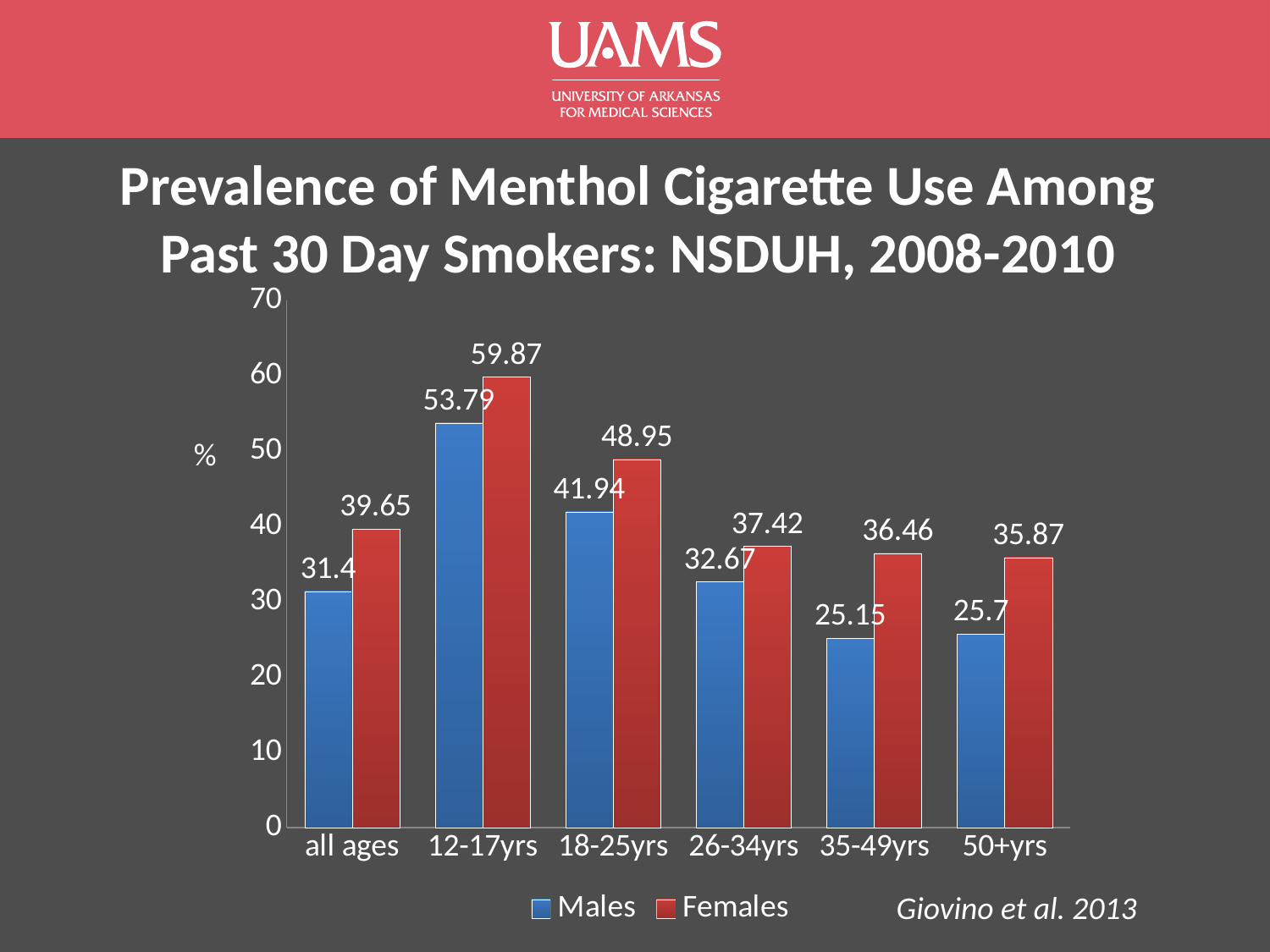
What is the difference between the Females and Males values in the 35-49yrs category? 11.31 Which age category has the lowest value for Males? 35-49yrs How many series does the legend list? 2 How many age categories are shown on the x axis? 6 Which is larger, the Males value for 18-25yrs or the Females value for 26-34yrs? Males value for 18-25yrs What is the value for Males in the 12-17yrs category? 53.79 Do the Females values rise or fall from 12-17yrs to 50+yrs? fall What is the value for Males in the all ages category? 31.4 What kind of chart is shown on the slide? bar chart Which age category has the highest value for Females? 12-17yrs What is the difference between the Females and Males values in the 12-17yrs category? 6.08 What is the value for Females in the 35-49yrs category? 36.46